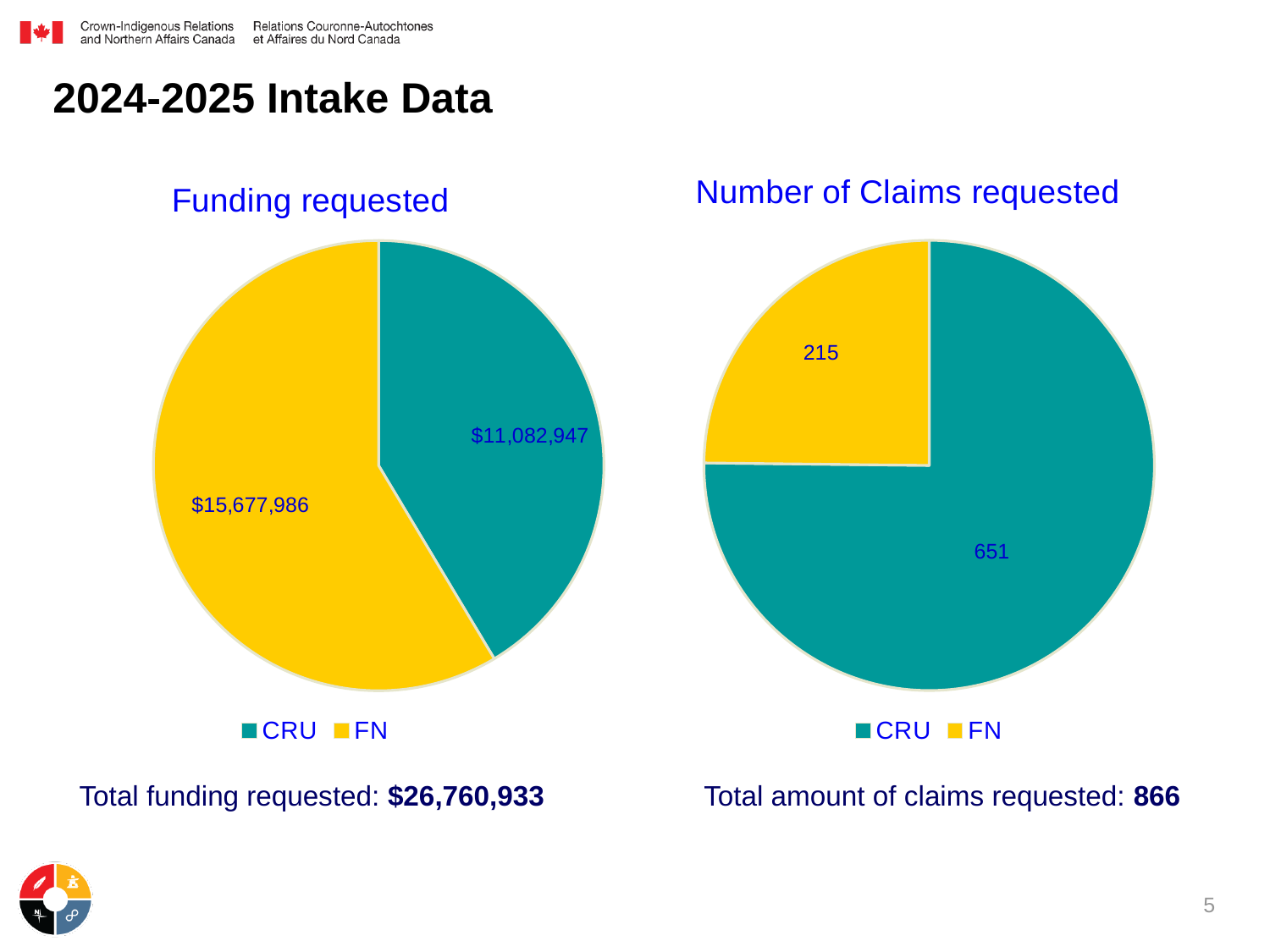
How many categories does the legend of the Number of Claims requested chart list? 2 In the Funding requested chart, which category has the larger slice? FN In the Funding requested chart, what is the difference between the FN and CRU values? $4,595,039 In the Number of Claims requested chart, which category has the smaller slice? FN In the Funding requested chart, what is the value for FN? $15,677,986 In the Number of Claims requested chart, how many more claims does CRU have than FN? 436 In the Number of Claims requested chart, how many claims are shown for CRU? 651 In the Number of Claims requested chart, is the value for CRU or FN larger? CRU In the Number of Claims requested chart, how many claims are shown for FN? 215 What type of chart is the Funding requested chart? Pie chart In the Funding requested chart, what is the value for CRU? $11,082,947 In the Funding requested chart, what colour is the FN slice? Yellow